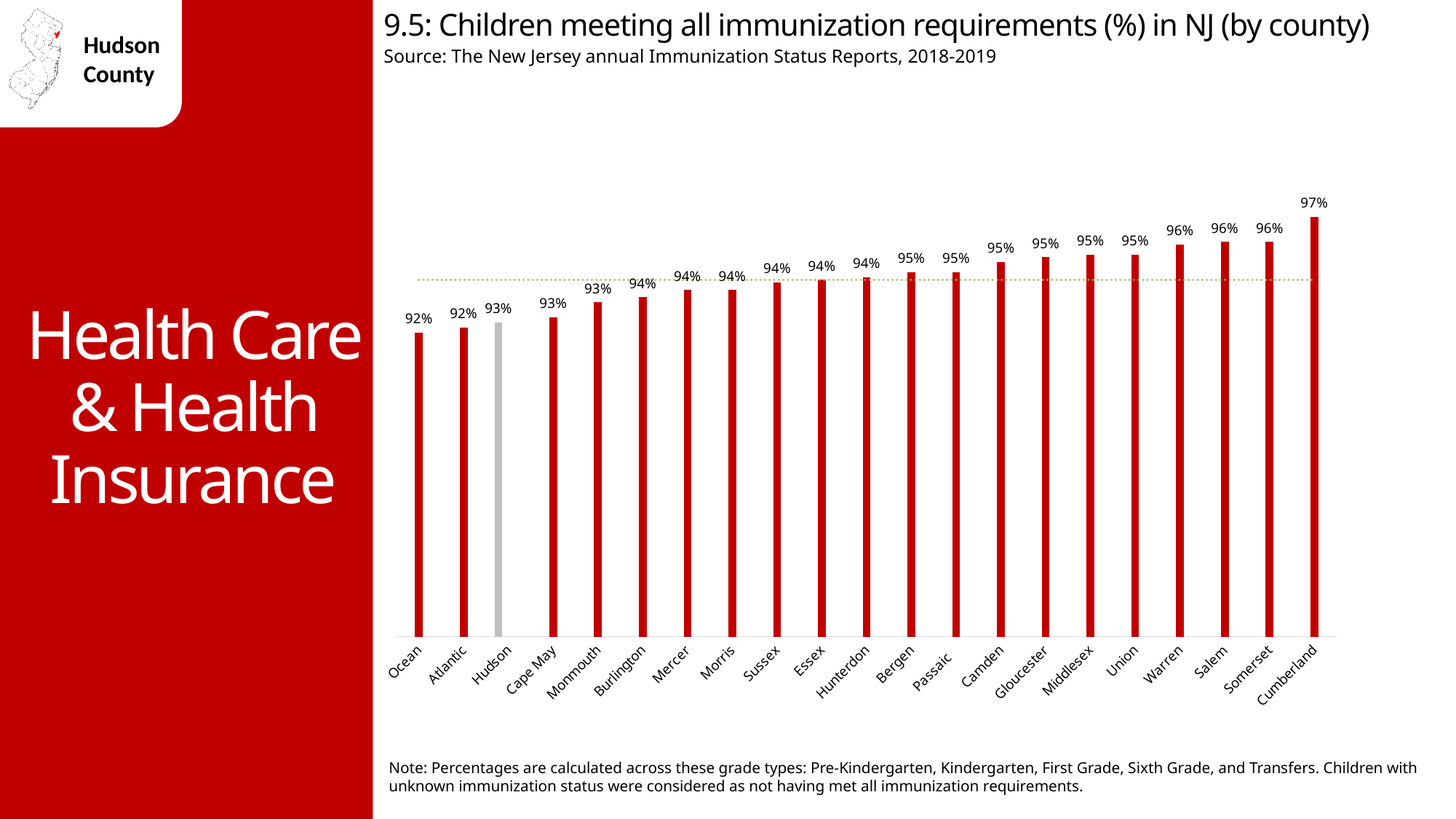
Which county's bar is coloured grey instead of red? Hudson Do the values rise or fall moving from left to right along the x axis? Rise What is the value shown for Bergen County? 95% What is the difference in percentage points between Warren and Ocean? 4 percentage points What is the value shown for Cumberland County? 97% How many counties are shown on the chart? 21 Which county has the highest percentage of children meeting all immunization requirements? Cumberland What percentage of children in Hudson County met all immunization requirements? 93% Which has a higher value, Somerset or Atlantic? Somerset What kind of chart is used on this slide? Bar chart What is the difference in percentage points between Cumberland and Hudson? 4 percentage points What is the value shown for Ocean County? 92%